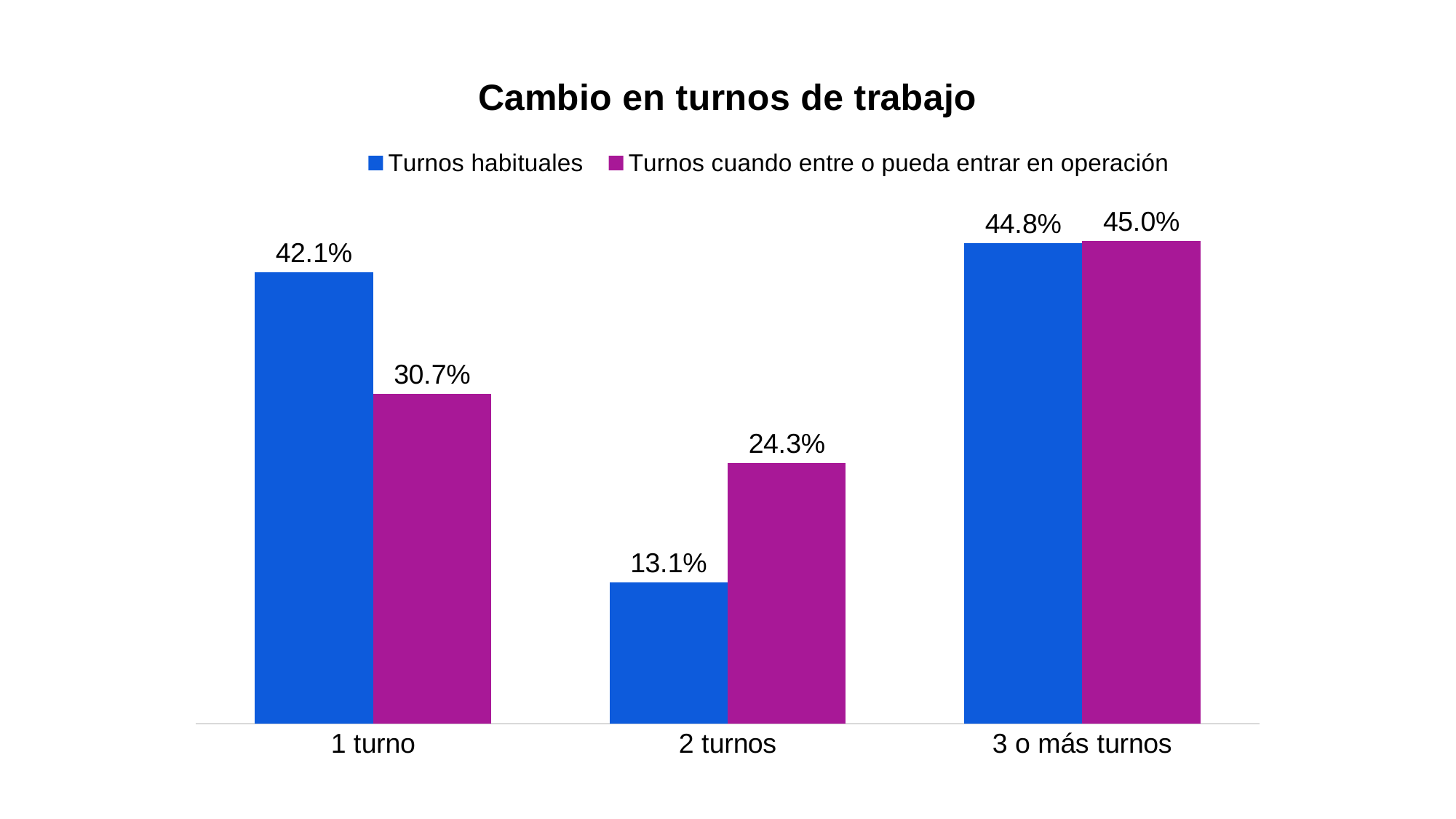
For "2 turnos", which series has the larger value? Turnos cuando entre o pueda entrar en operación Which category has the highest value in the "Turnos cuando entre o pueda entrar en operación" series? 3 o más turnos What kind of chart is shown on the slide? Bar chart What is the value for "1 turno" in the "Turnos habituales" series? 42.1% What is the title of the chart? Cambio en turnos de trabajo How many series does the legend list? 2 What is the value for "2 turnos" in the "Turnos cuando entre o pueda entrar en operación" series? 24.3% What is the value for "3 o más turnos" in the "Turnos habituales" series? 44.8% How many categories are shown on the x axis? 3 Which category has the lowest value in the "Turnos habituales" series? 2 turnos What is the difference between the two series' values for "2 turnos"? 11.2% What is the difference between the "Turnos habituales" and "Turnos cuando entre o pueda entrar en operación" values for "1 turno"? 11.4%